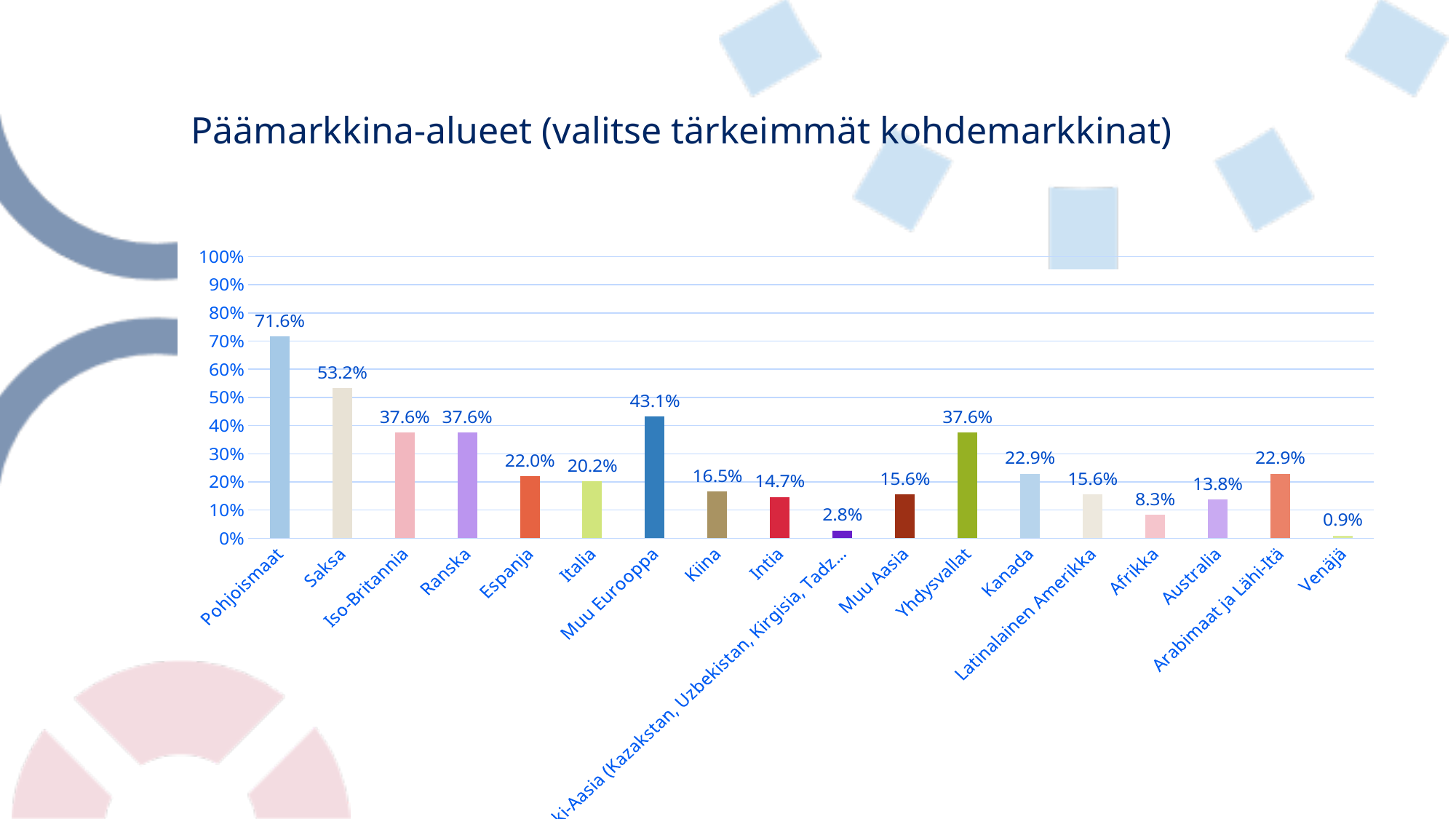
Which category has the highest value? Pohjoismaat Is the value for Saksa greater or less than 50%? greater What is the value for Afrikka? 8.3% What kind of chart is shown on the slide? bar chart How many categories are shown on the x axis? 18 What is the value for Yhdysvallat? 37.6% Which is larger, the value for Kiina or the value for Intia? Kiina What is the value for Muu Eurooppa? 43.1% What is the difference between the values for Pohjoismaat and Saksa? 18.4% What is the value for Pohjoismaat? 71.6% Which category has the lowest value? Venäjä What is the title of the chart? Päämarkkina-alueet (valitse tärkeimmät kohdemarkkinat)